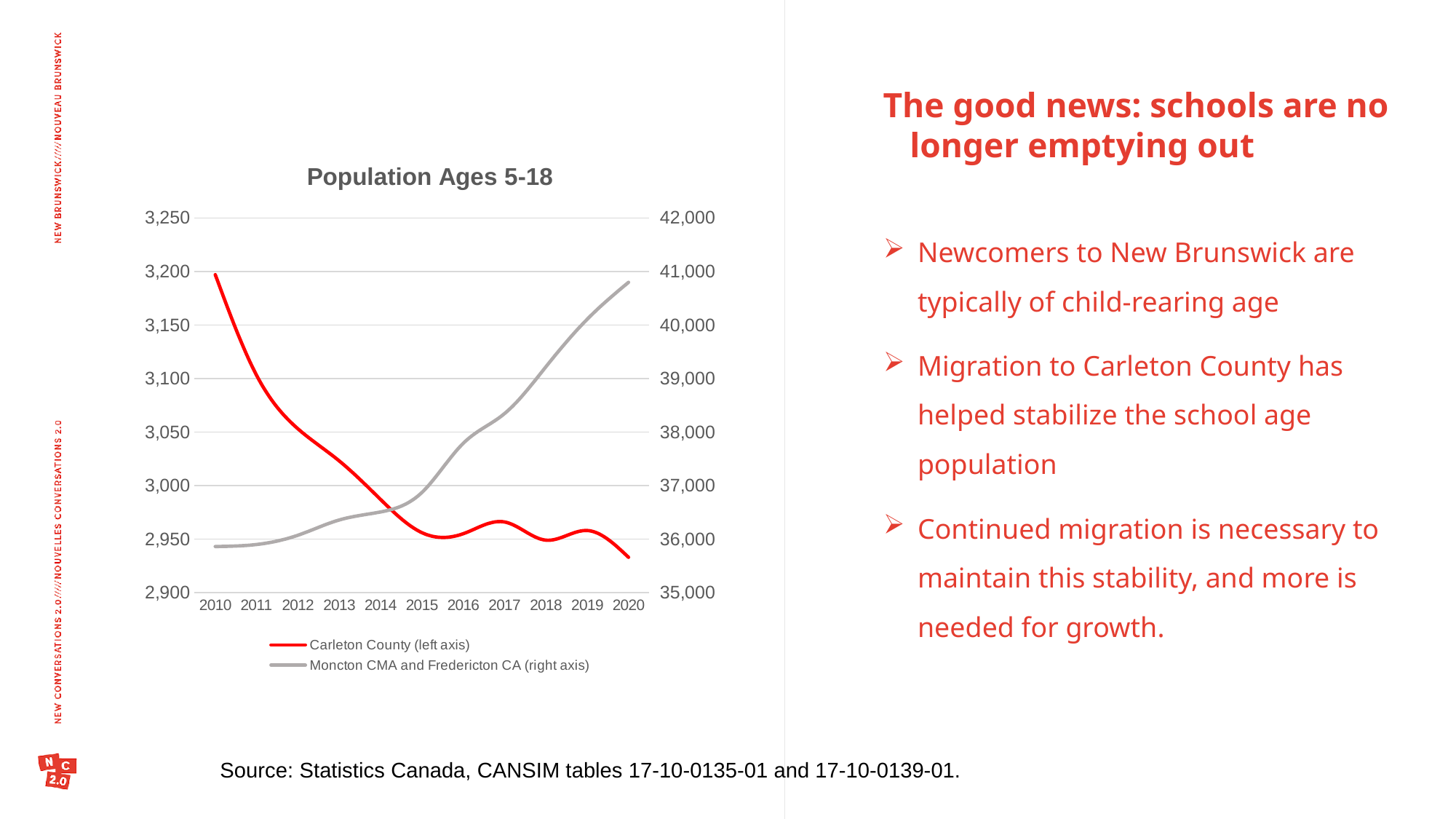
Which series is plotted against the right axis? Moncton CMA and Fredericton CA Does the Moncton CMA and Fredericton CA line rise or fall overall from 2010 to 2020? rise How many years are shown along the x axis of the chart? 11 How many series does the chart's legend list? 2 What kind of chart is shown on the slide? line chart Is the Carleton County value for 2020 greater or less than 2,950? less Is the Moncton CMA and Fredericton CA value for 2010 greater or less than 36,000? less Is the Moncton CMA and Fredericton CA value for 2020 greater or less than 40,000? greater Does the Carleton County line rise or fall overall from 2010 to 2020? fall What is the title of the chart? Population Ages 5-18